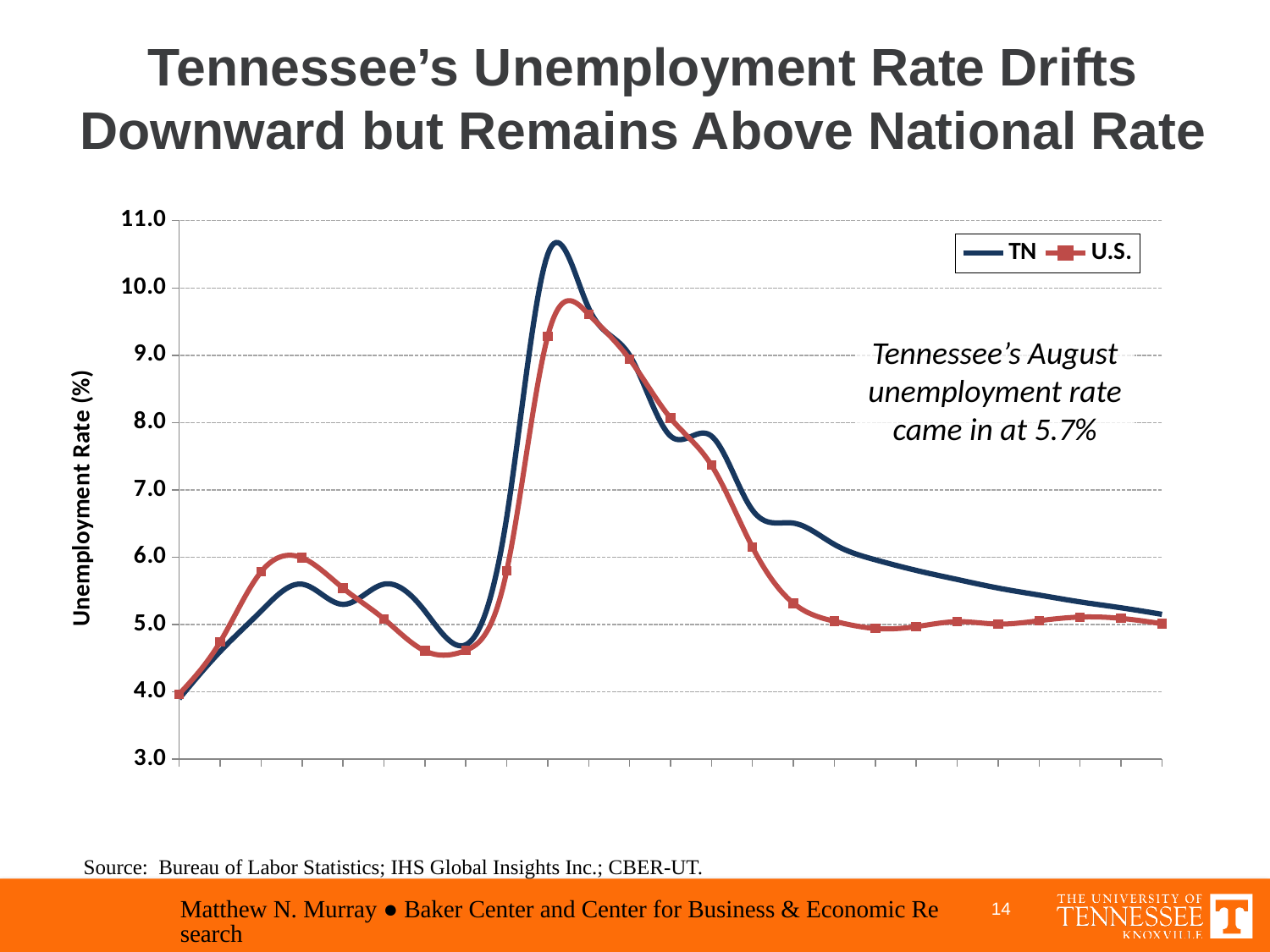
Is the final value of the U.S. series at the right of the chart greater or less than 6.0? less What is the highest value shown on the vertical axis? 11.0 Which series reaches the higher peak, TN or U.S.? TN Is the starting value of the TN series at the left of the chart greater or less than 5.0? less How many series does the legend list? 2 Is the peak value of the U.S. series greater or less than 10.0? less What is the label on the vertical axis? Unemployment Rate (%) What are the two series named in the legend? TN and U.S. According to the annotation on the chart, what was Tennessee's August unemployment rate? 5.7% Over the right-hand portion of the chart after the peak, does the TN series rise or fall? fall What kind of chart is shown on the slide? line chart